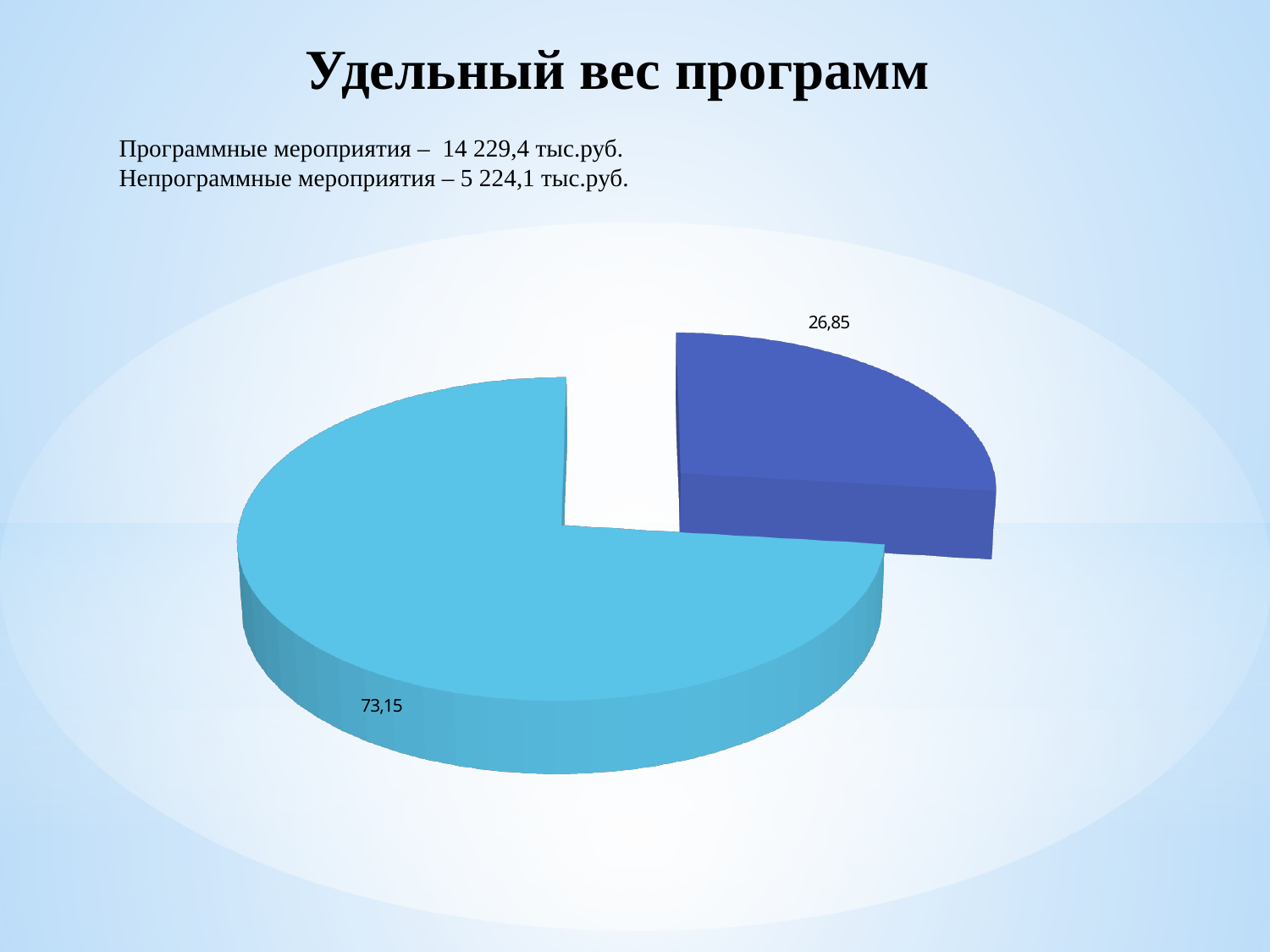
How many slices does the pie chart have? 2 Which slice of the pie chart is pulled out (exploded) from the rest? the dark-blue slice (26,85) What is the value of the largest slice in the pie chart? 73,15 What is the value of the smallest slice in the pie chart? 26,85 What is the title of the slide containing the pie chart? Удельный вес программ What value is labelled on the small dark-blue slice of the pie chart? 26,85 What do the two slice values in the pie chart add up to? 100 Is the value of the dark-blue slice greater or less than 50? less What is the difference between the two slice values in the pie chart (73,15 and 26,85)? 46,3 What value is labelled on the large light-blue slice of the pie chart? 73,15 What type of chart is shown on the slide? pie chart Which slice is larger, the light-blue one or the dark-blue one? the light-blue one